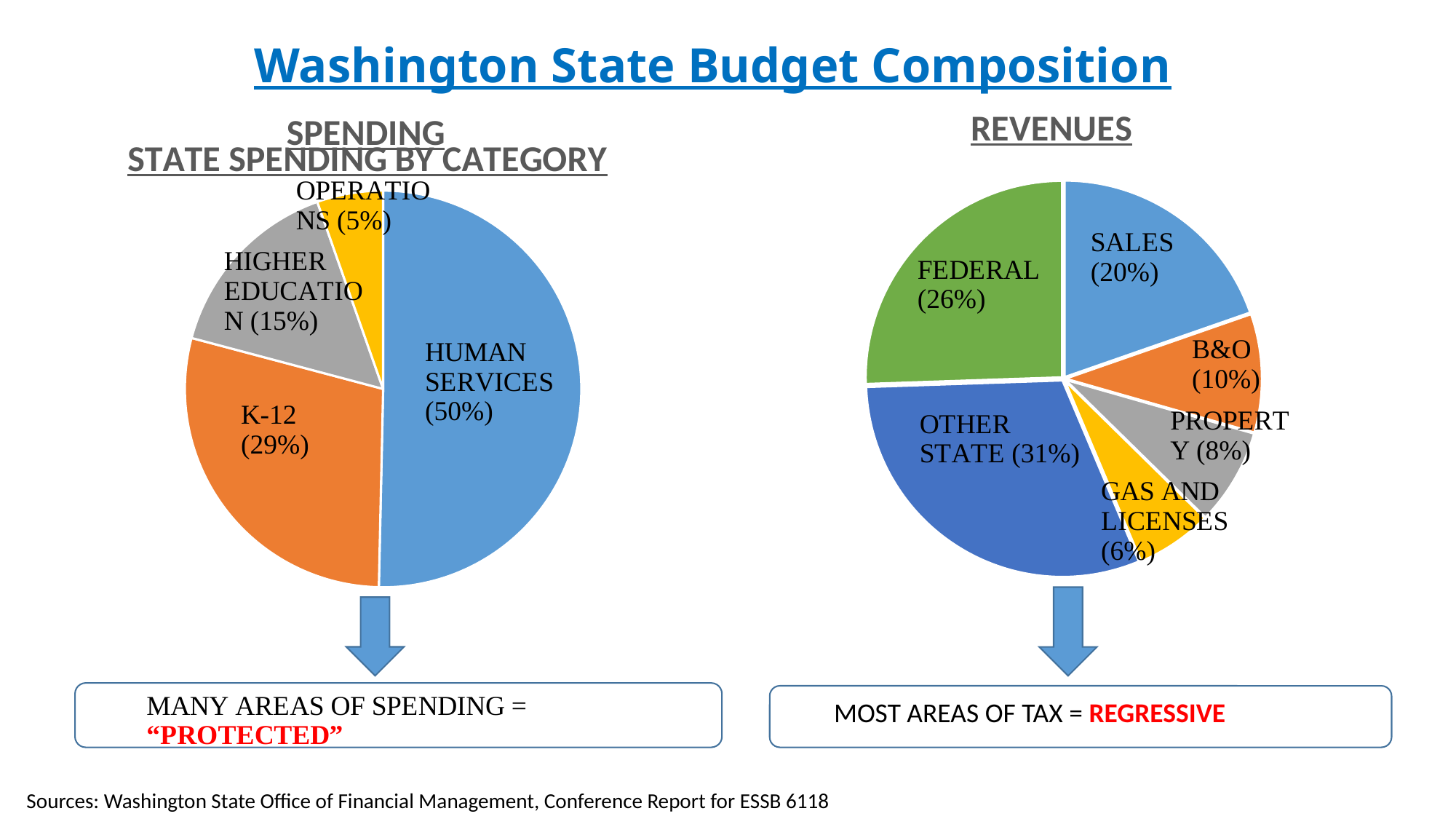
In the Spending pie chart, how many categories are shown? 4 What type of chart is used for the Revenues data? Pie chart What is the title of the slide? Washington State Budget Composition In the Revenues pie chart, which category has the largest share? Other State In the Revenues pie chart, what share of revenues comes from Federal sources? 26% In the Spending pie chart, what share of state spending goes to K-12? 29% In the Revenues pie chart, what share of revenues comes from Property? 8% In the Spending pie chart, which category has the smallest share? Operations In the Revenues pie chart, which is larger, Sales or B&O? Sales In the Spending pie chart, what is the difference in percentage points between K-12 and Higher Education? 14 In the Revenues pie chart, how many categories are shown? 6 In the Spending pie chart, what share of state spending goes to Human Services? 50%